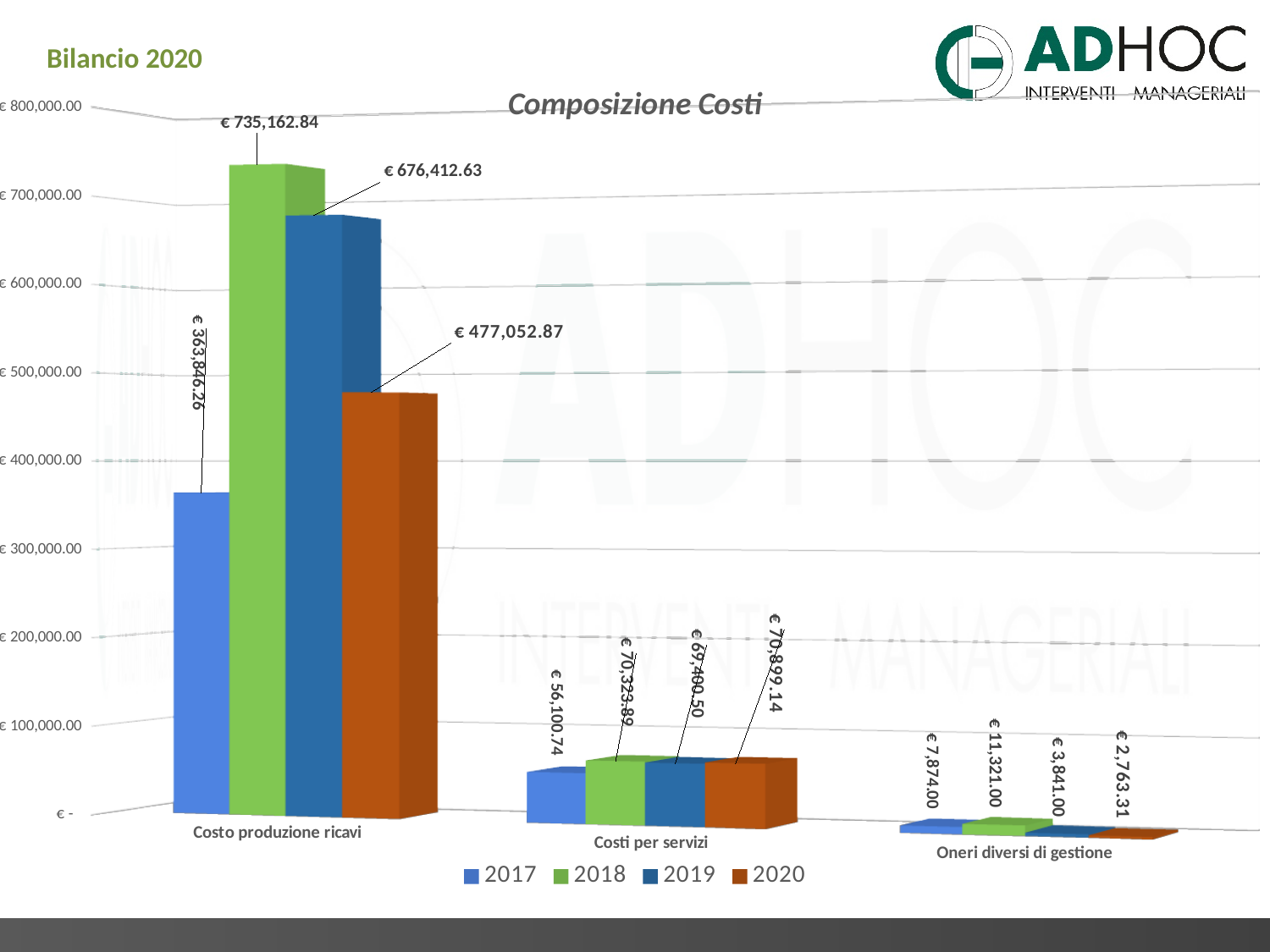
Is the 2018 value for Costo produzione ricavi greater or less than € 700,000.00? greater What is the value for 2017 in the Costi per servizi category? € 56,100.74 What kind of chart is shown on the slide? bar chart Which is larger in the Costo produzione ricavi category, the 2017 value or the 2020 value? 2020 How many categories are shown on the x axis? 3 What is the value for 2019 in the Oneri diversi di gestione category? € 3,841.00 What is the difference between the 2018 and 2019 values in the Costo produzione ricavi category? € 58,750.21 How many series does the legend list? 4 Which year has the highest value in the Costo produzione ricavi category? 2018 What is the value for 2018 in the Costo produzione ricavi category? € 735,162.84 What is the value for 2020 in the Costo produzione ricavi category? € 477,052.87 Which year has the lowest value in the Oneri diversi di gestione category? 2020